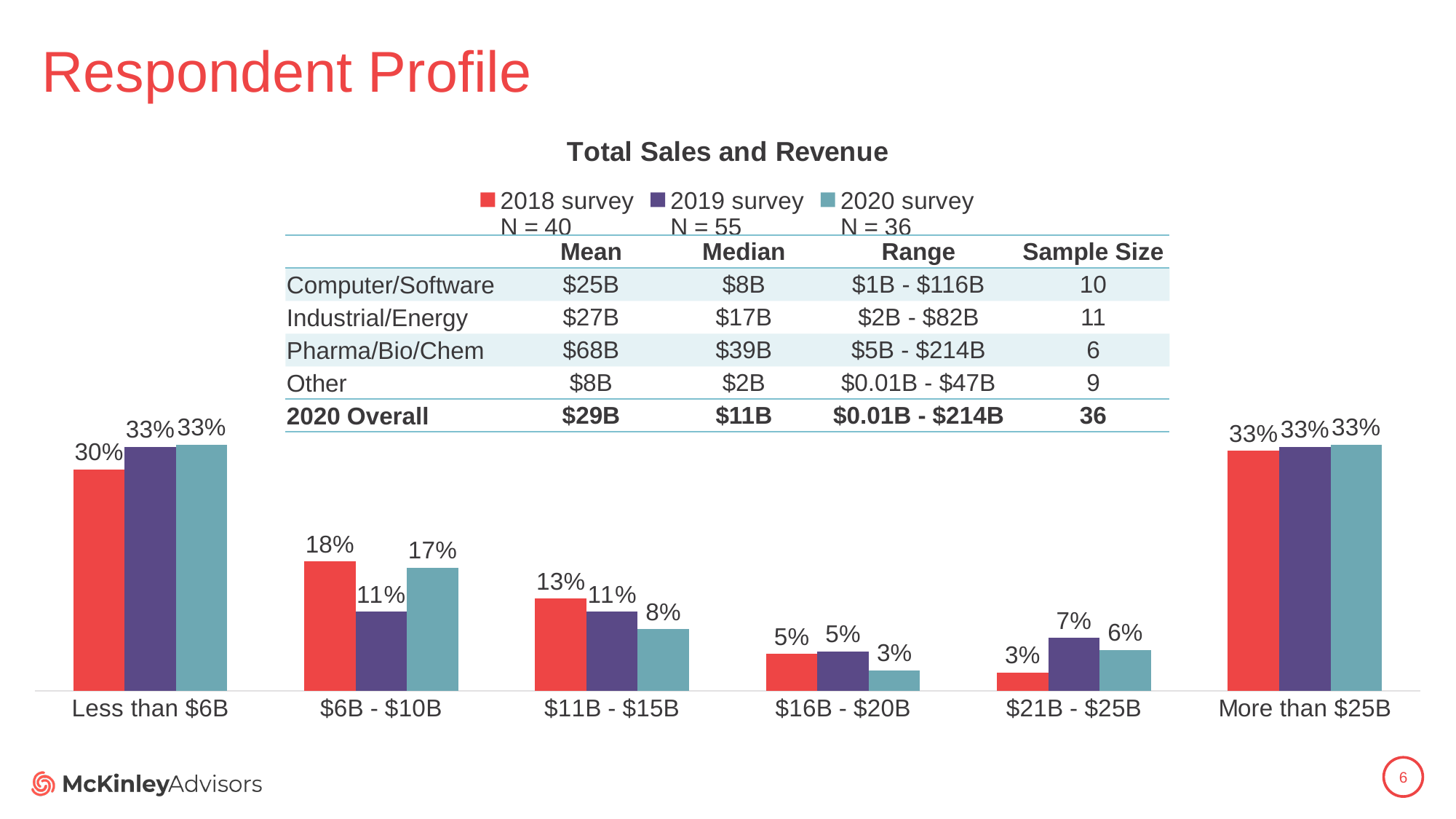
What is the title of the chart? Total Sales and Revenue What is the sample size (N) for the 2019 survey shown in the legend? 55 What is the value for the 2018 survey in the "Less than $6B" category? 30% Which category has the lowest value for the 2018 survey? $21B - $25B What is the difference between the 2018 survey and 2019 survey values in the "$6B - $10B" category? 7% What is the value for the 2020 survey in the "$11B - $15B" category? 8% Which is larger in the "$11B - $15B" category: the 2018 survey value or the 2020 survey value? 2018 survey How many series does the chart's legend list? 3 Which category has the lowest value for the 2020 survey? $16B - $20B What kind of chart is shown on the slide? Bar chart What is the value for the 2019 survey in the "$21B - $25B" category? 7% How many categories are shown on the x axis of the chart? 6